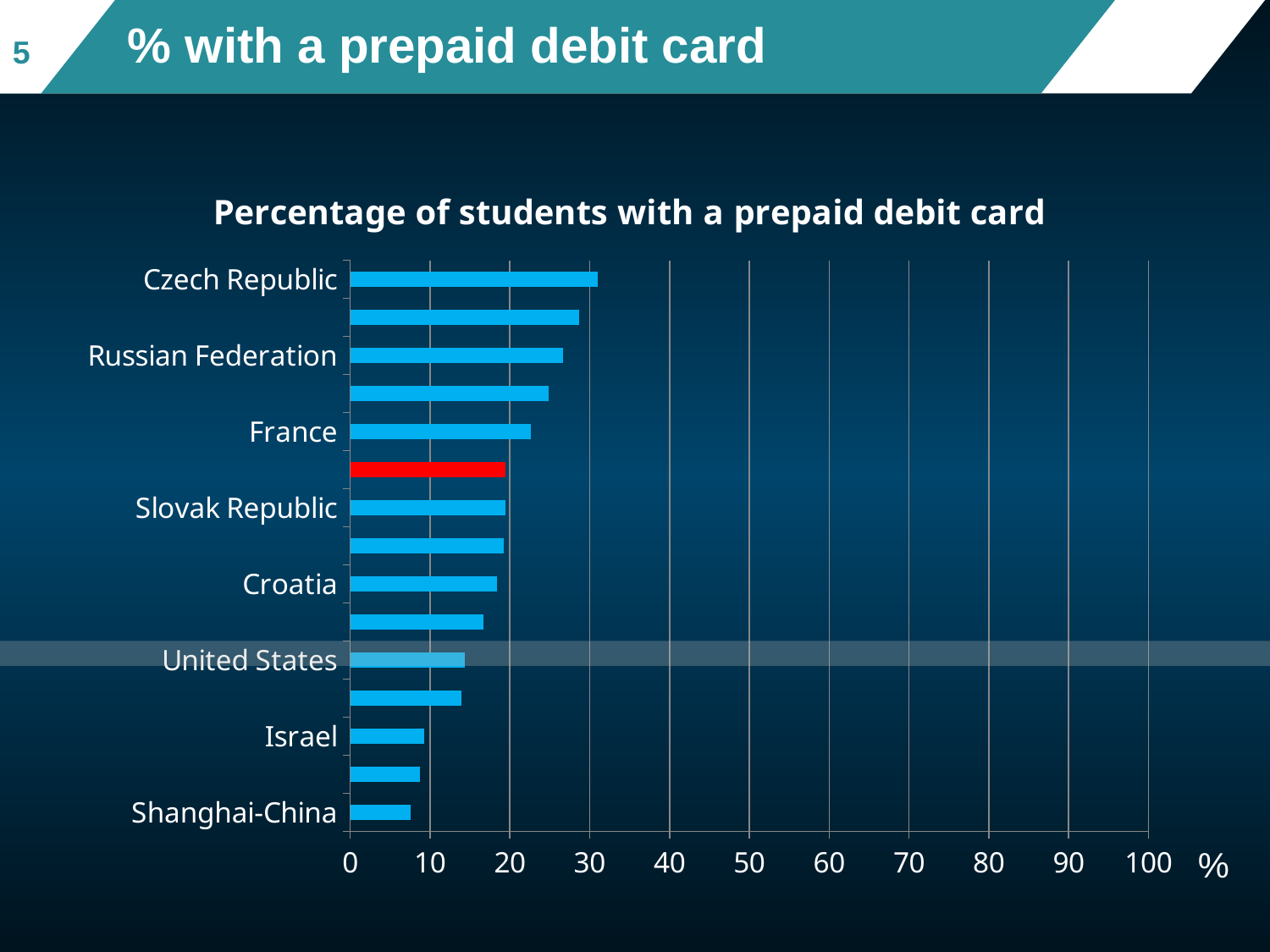
Which labelled country has the lowest percentage of students with a prepaid debit card? Shanghai-China How many bars are plotted in the chart? 15 Which has a higher value, United States or France? France What is the title of the chart? Percentage of students with a prepaid debit card Which has a higher value, Russian Federation or Croatia? Russian Federation Is the value for France greater or less than 30? less Do the bar values increase or decrease going from the top of the chart to the bottom? decrease Is the value for Czech Republic greater or less than 20? greater What type of chart is shown on the slide? bar chart Is the value for United States greater or less than 20? less Which labelled country has the highest percentage of students with a prepaid debit card? Czech Republic